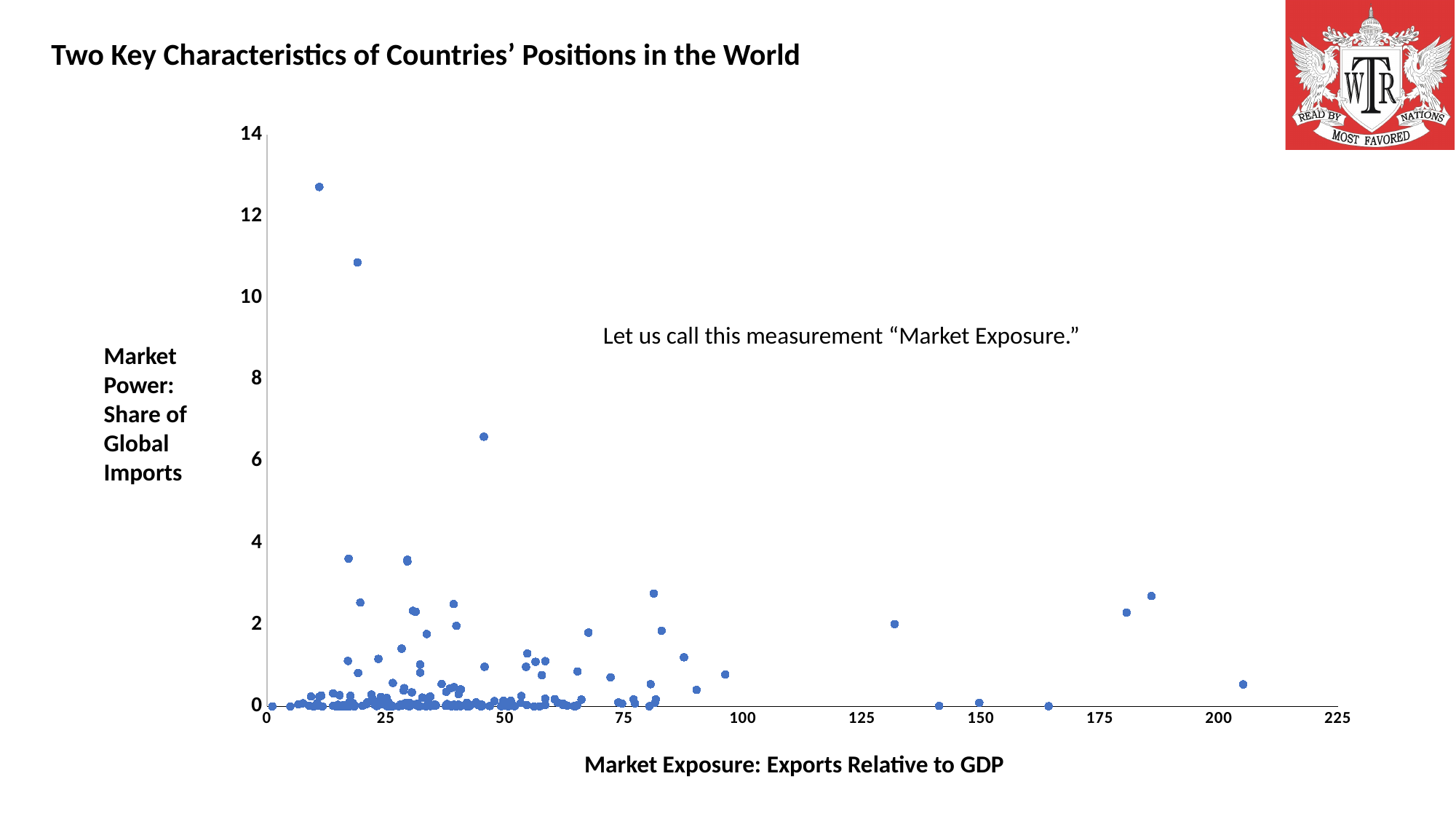
Is the Market Power value of the highest point on the chart greater or less than 12? greater Is the Market Exposure value of the rightmost point on the chart greater or less than 200? greater Is the Market Exposure value of the highest point on the chart greater or less than 25? less Which point has the greater Market Power: the one near Market Exposure 130 or the one near Market Exposure 205? the one near 130 What is the title of the horizontal axis? Market Exposure: Exports Relative to GDP What is the title of the vertical axis? Market Power: Share of Global Imports Do the points with the highest Market Power appear at low or high Market Exposure? low What kind of chart is shown on the slide? scatter chart